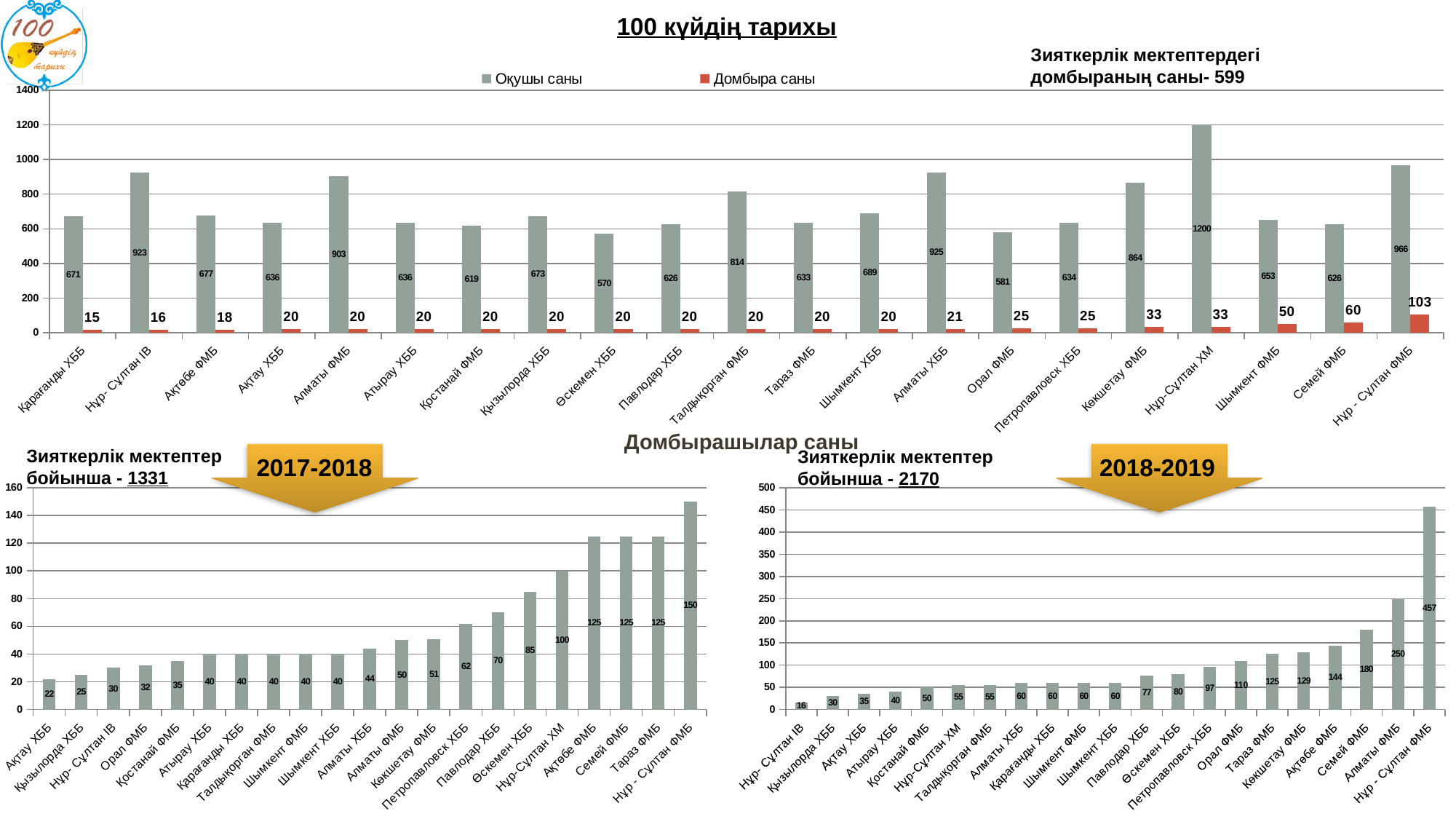
In the bottom-right chart (2018-2019), which is larger: the value for Орал ФМБ or the value for Петропавловск ХББ? Орал ФМБ In the top chart, what is the Домбыра саны value for Нұр - Сұлтан ФМБ? 103 In the bottom-left chart (2017-2018), which category has the highest value? Нұр - Сұлтан ФМБ How many categories are shown in the bottom-left chart (2017-2018)? 21 In the bottom-right chart (2018-2019), what is the difference between the values for Нұр - Сұлтан ФМБ and Алматы ФМБ? 207 In the top chart, what is the Оқушы саны value for Нұр-Сұлтан ХМ? 1200 In the bottom-right chart (2018-2019), what is the value for Семей ФМБ? 180 In the bottom-left chart (2017-2018), what is the value for Өскемен ХББ? 85 How many series does the legend of the top chart list? 2 What kind of chart is the top chart? Bar chart In the top chart, what is the difference between the Оқушы саны values for Алматы ХББ and Орал ФМБ? 344 In the top chart, which category has the lowest Домбыра саны value? Қарағанды ХББ